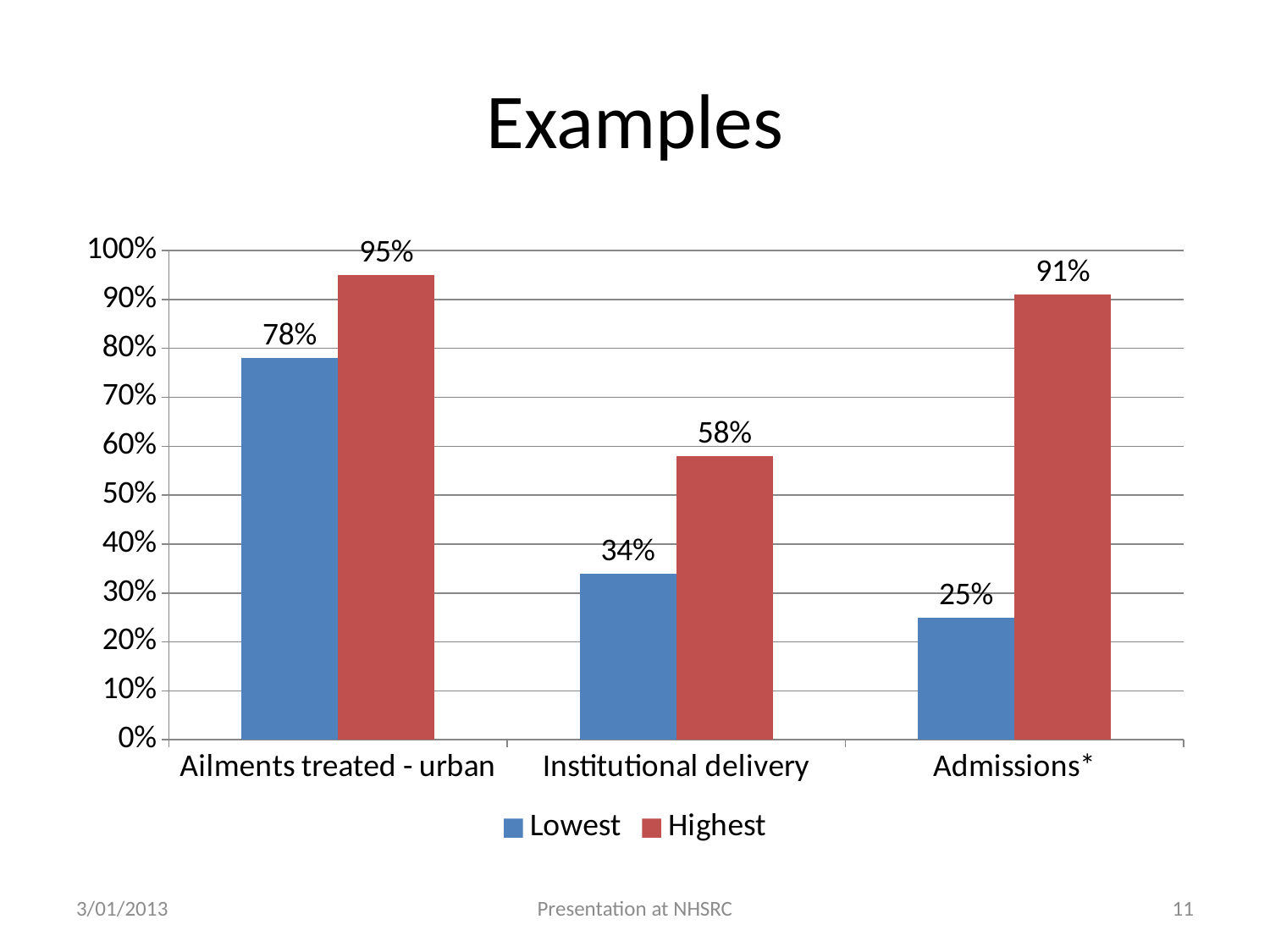
How many categories are shown on the x axis? 3 Which category has the highest Highest value? Ailments treated - urban What is the Highest value for Admissions*? 91% What is the Lowest value for Admissions*? 25% What kind of chart is shown on the slide? Bar chart Which is larger: the Lowest value for Ailments treated - urban or the Highest value for Institutional delivery? Lowest value for Ailments treated - urban Which category has the lowest Lowest value? Admissions* What is the Lowest value for Ailments treated - urban? 78% What is the difference between the Highest and Lowest values for Institutional delivery? 24% How many series does the legend list? 2 What is the Highest value for Institutional delivery? 58% What is the difference between the Highest and Lowest values for Admissions*? 66%